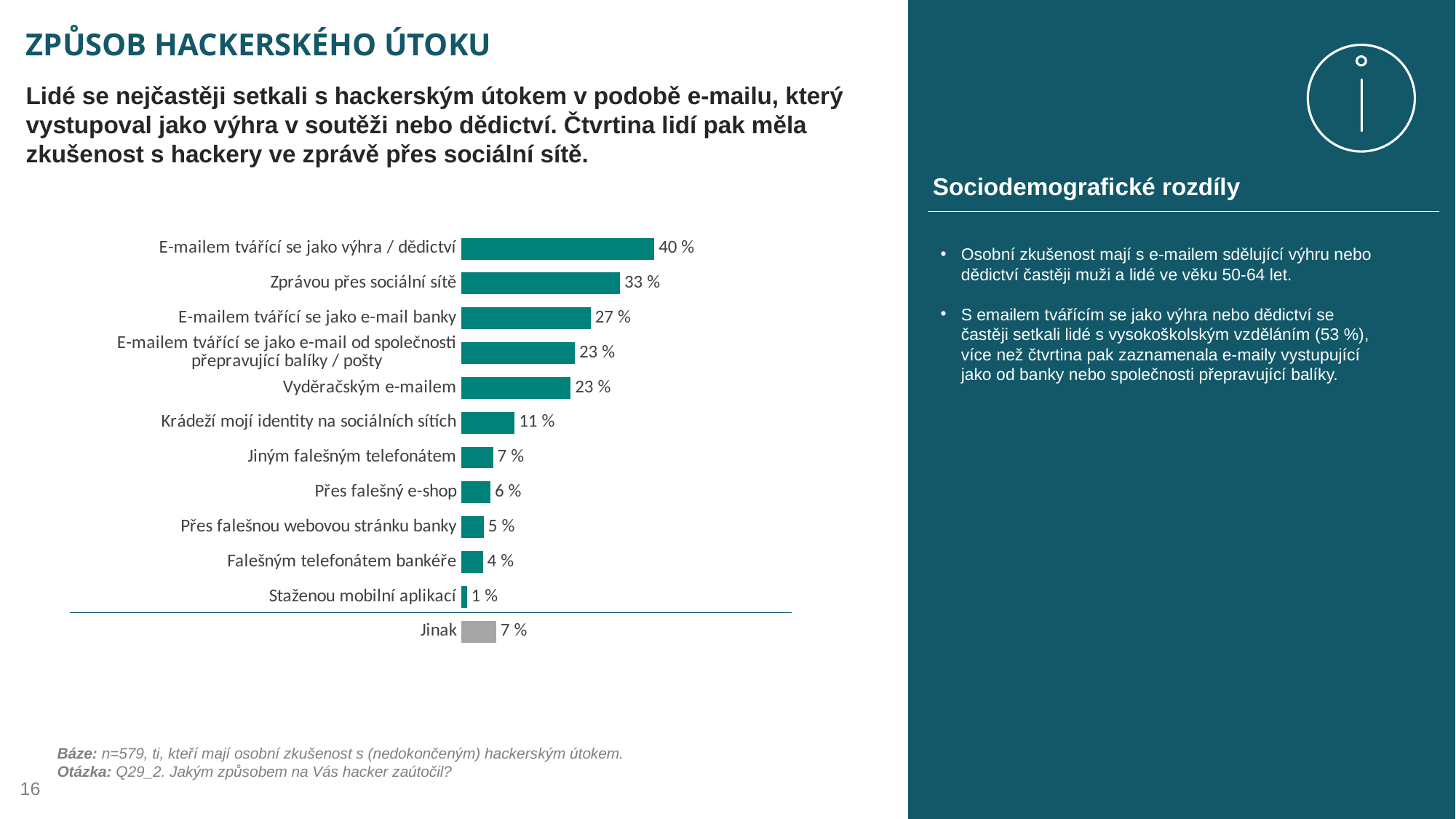
What is the difference between the values for "E-mailem tvářící se jako výhra / dědictví" and "Zprávou přes sociální sítě"? 7 % Which category's bar is shown in gray rather than teal? Jinak Which is larger: the value for "Přes falešný e-shop" or the value for "Falešným telefonátem bankéře"? Přes falešný e-shop What is the value for "Zprávou přes sociální sítě"? 33 % What is the value for "Staženou mobilní aplikací"? 1 % What kind of chart is shown on the slide? bar chart What is the value for "Krádeží mojí identity na sociálních sítích"? 11 % How many categories are shown in the chart? 12 What is the difference between the values for "E-mailem tvářící se jako e-mail banky" and "Vyděračským e-mailem"? 4 % Which category has the highest value? E-mailem tvářící se jako výhra / dědictví What is the value for "Jinak"? 7 % Which category has the lowest value? Staženou mobilní aplikací